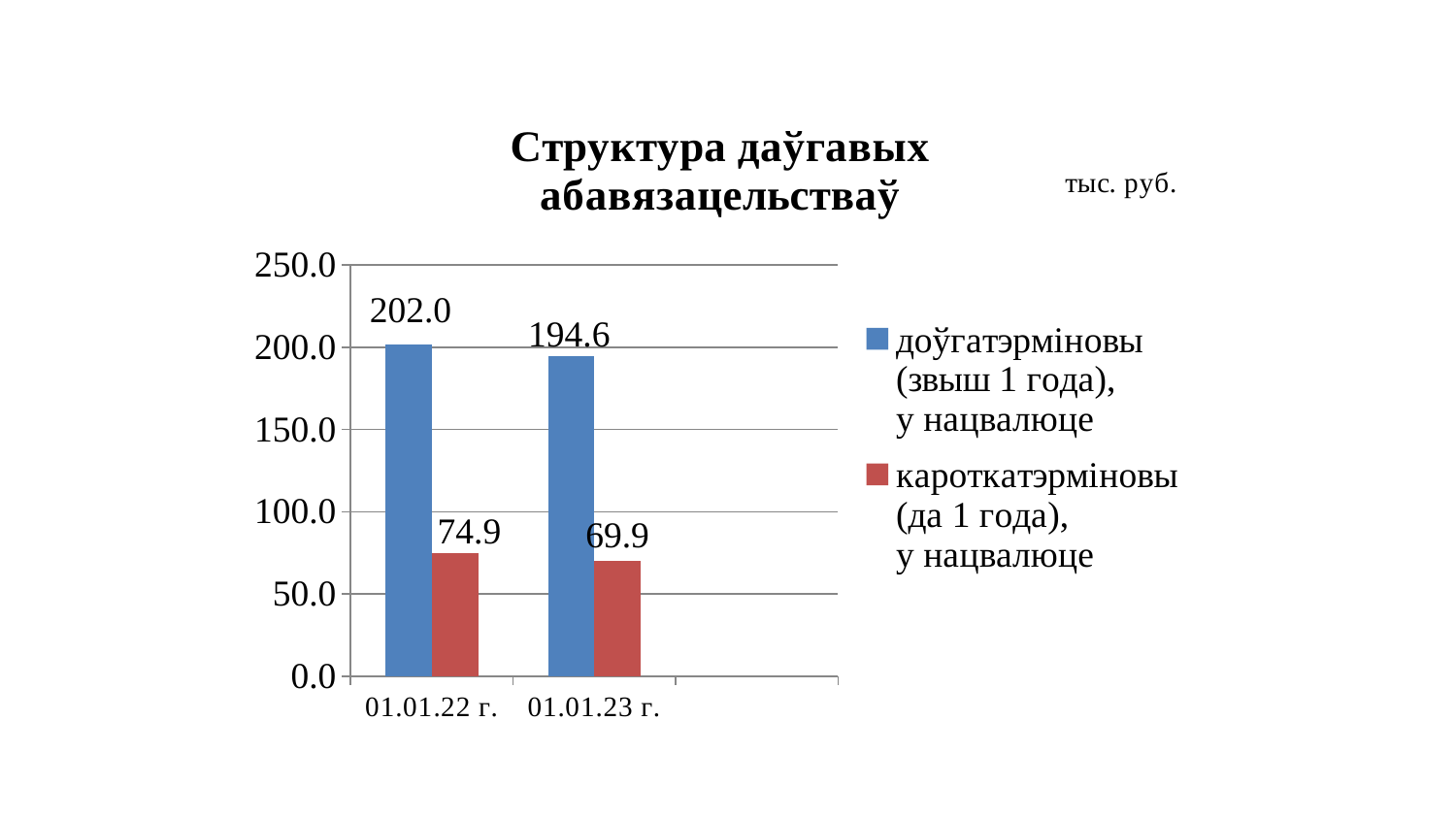
Does the long-term (доўгатэрміновы) series rise or fall from 01.01.22 г. to 01.01.23 г.? fall How many series does the legend list? 2 What is the difference between the short-term values for 01.01.22 г. and 01.01.23 г.? 5.0 What is the value of the long-term (доўгатэрміновы) series for 01.01.23 г.? 194.6 What is the value of the short-term (кароткатэрміновы) series for 01.01.22 г.? 74.9 What is the value of the long-term (доўгатэрміновы) series for 01.01.22 г.? 202.0 What kind of chart is shown on the slide? bar chart Which date has the lower value for the short-term (кароткатэрміновы) series? 01.01.23 г. What is the value of the short-term (кароткатэрміновы) series for 01.01.23 г.? 69.9 Which date has the higher value for the long-term (доўгатэрміновы) series? 01.01.22 г. For 01.01.23 г., which is larger: the long-term or the short-term value? long-term (доўгатэрміновы) What is the difference between the long-term values for 01.01.22 г. and 01.01.23 г.? 7.4